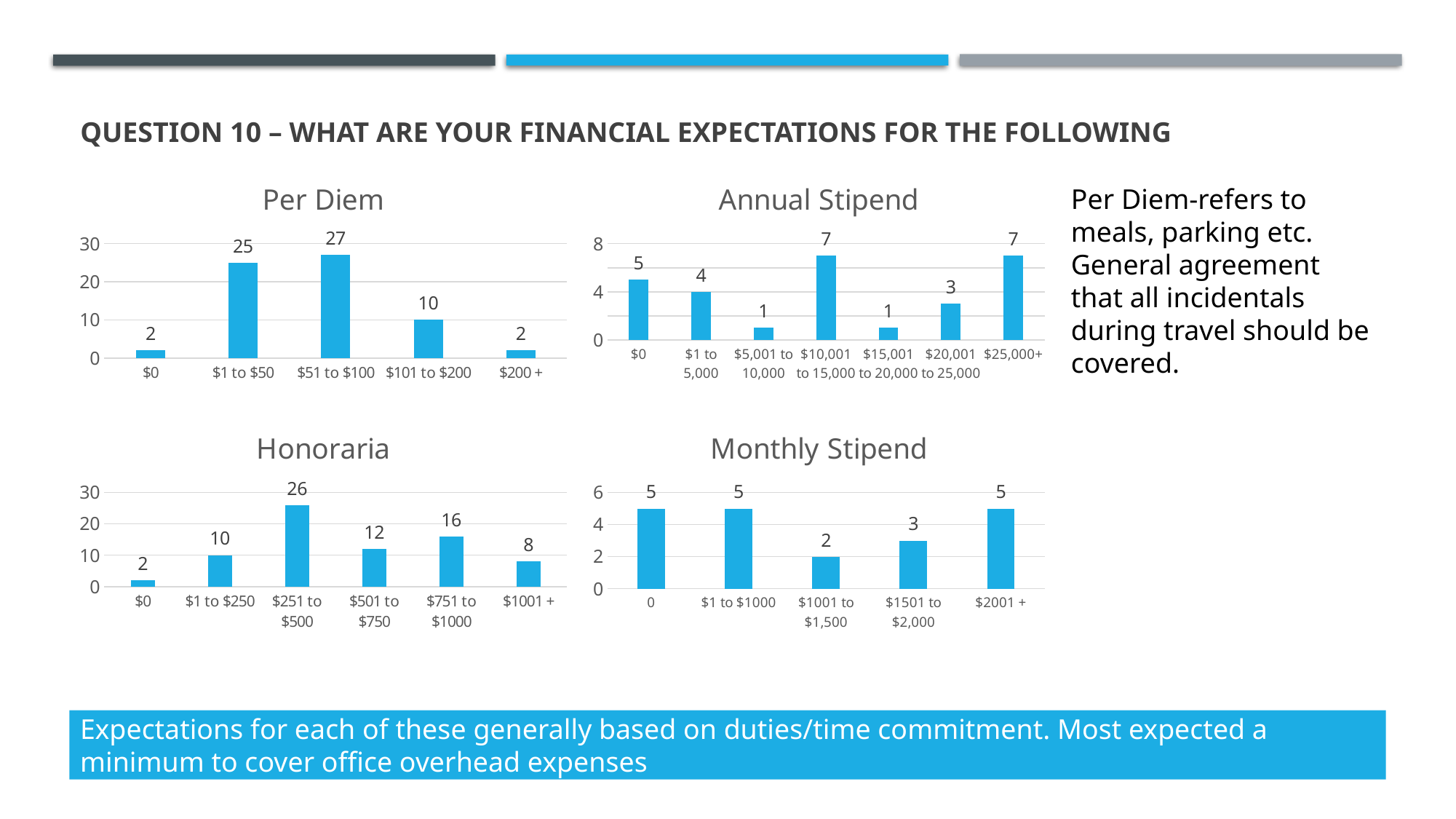
In the Per Diem chart, which category has the highest value? $51 to $100 In the Honoraria chart, which category has the lowest value? $0 In the Monthly Stipend chart, which category has the lowest value? $1001 to $1,500 In the Annual Stipend chart, what is the value for $1 to 5,000? 4 In the Annual Stipend chart, what is the total of the values for $10,001 to 15,000 and $25,000+? 14 In the Annual Stipend chart, how many categories are shown on the x axis? 7 What kind of chart is the Honoraria chart? Bar chart How many charts are shown on the slide? 4 In the Per Diem chart, which is larger, the value for $1 to $50 or the value for $101 to $200? $1 to $50 In the Honoraria chart, what is the difference between the values for $251 to $500 and $751 to $1000? 10 In the Monthly Stipend chart, what is the value for $1501 to $2,000? 3 In the Per Diem chart, what is the value for $51 to $100? 27